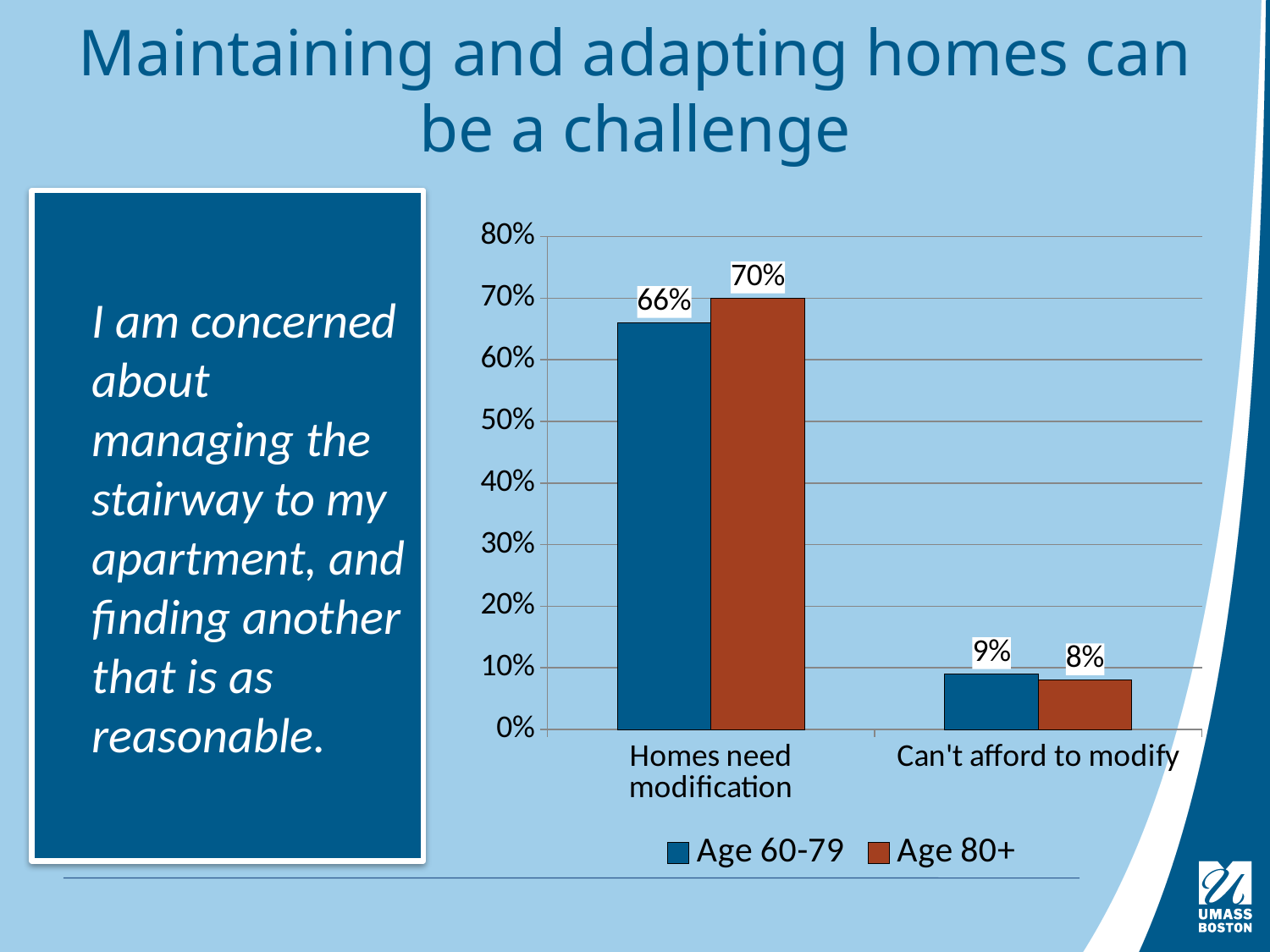
What percentage of the Age 80+ group say they can't afford to modify? 8% What percentage of the Age 60-79 group say homes need modification? 66% What is the difference between the Age 60-79 and Age 80+ values for 'Can't afford to modify'? 1% What percentage of the Age 80+ group say homes need modification? 70% Which colour represents the Age 80+ series in the chart? Red/orange How many categories are shown on the x axis? 2 What type of chart is shown on the slide? Bar chart What is the difference between the Age 80+ and Age 60-79 values for 'Homes need modification'? 4% What percentage of the Age 60-79 group say they can't afford to modify? 9% How many series does the legend list? 2 Which age group has the higher value for 'Homes need modification'? Age 80+ Which category has the highest value on the chart? Homes need modification